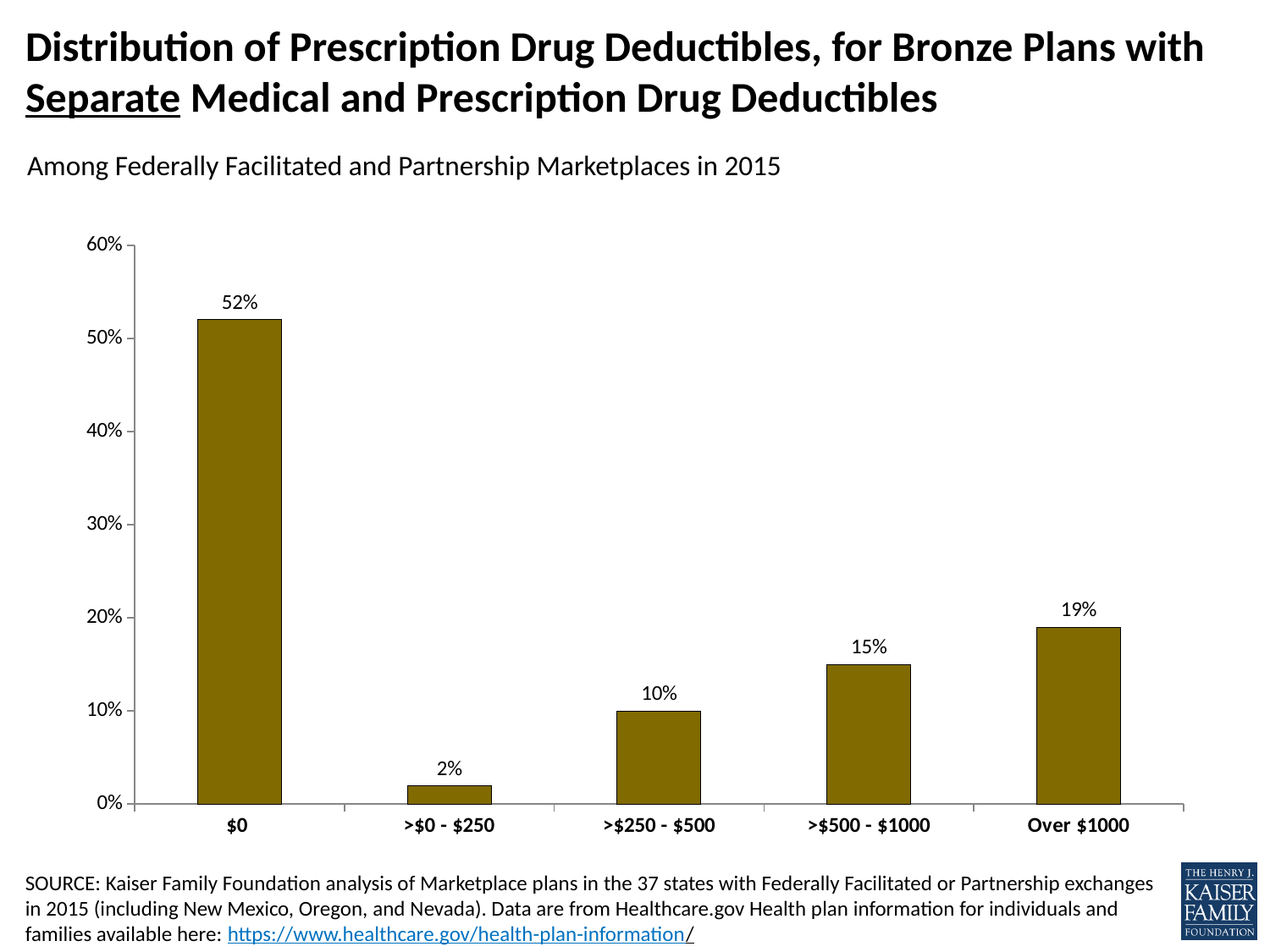
What percentage of plans have a prescription drug deductible of $0? 52% What is the difference between the >$500 - $1000 category and the >$250 - $500 category? 5% What is the value for the >$500 - $1000 category? 15% Which is larger, the value for >$250 - $500 or the value for Over $1000? Over $1000 Which deductible category has the highest share of plans? $0 Which deductible category has the lowest share of plans? >$0 - $250 What is the difference between the $0 category and the Over $1000 category? 33% How many deductible categories are shown on the x axis? 5 Is the value for the $0 category greater or less than 50%? greater What is the subtitle shown below the chart title? Among Federally Facilitated and Partnership Marketplaces in 2015 What is the value for the Over $1000 category? 19% What kind of chart is shown on the slide? Bar chart